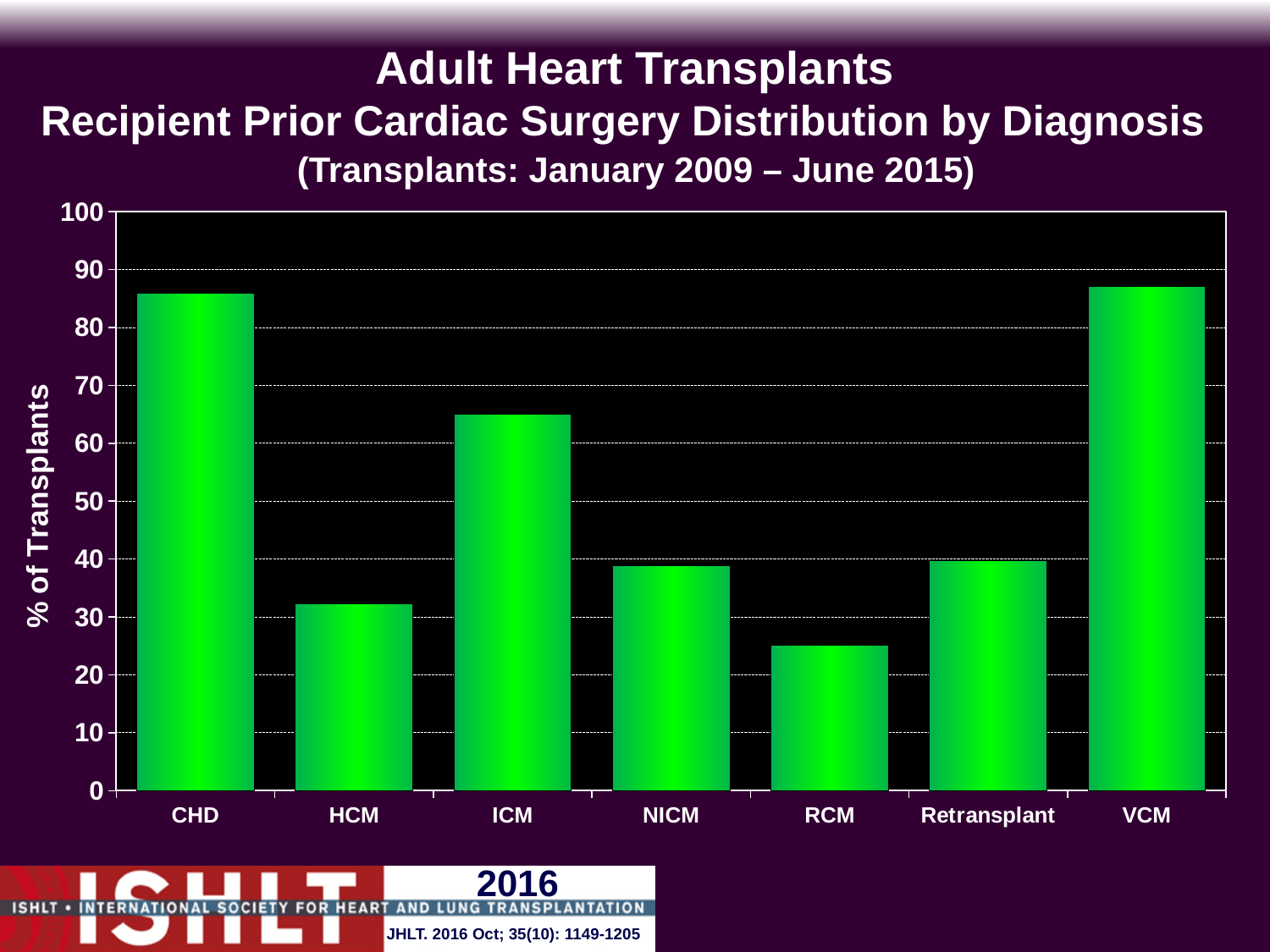
Which has a higher % of transplants, RCM or Retransplant? Retransplant How many diagnosis categories are shown on the x axis? 7 What transplant period is given in the chart title? January 2009 – June 2015 Is the value for CHD greater or less than 80? greater Is the value for VCM greater or less than 80? greater Which has a higher % of transplants, ICM or HCM? ICM Which diagnosis category has the lowest % of transplants? RCM Is the value for HCM greater or less than 40? less What kind of chart is shown on the slide? bar chart What is the label of the y axis? % of Transplants